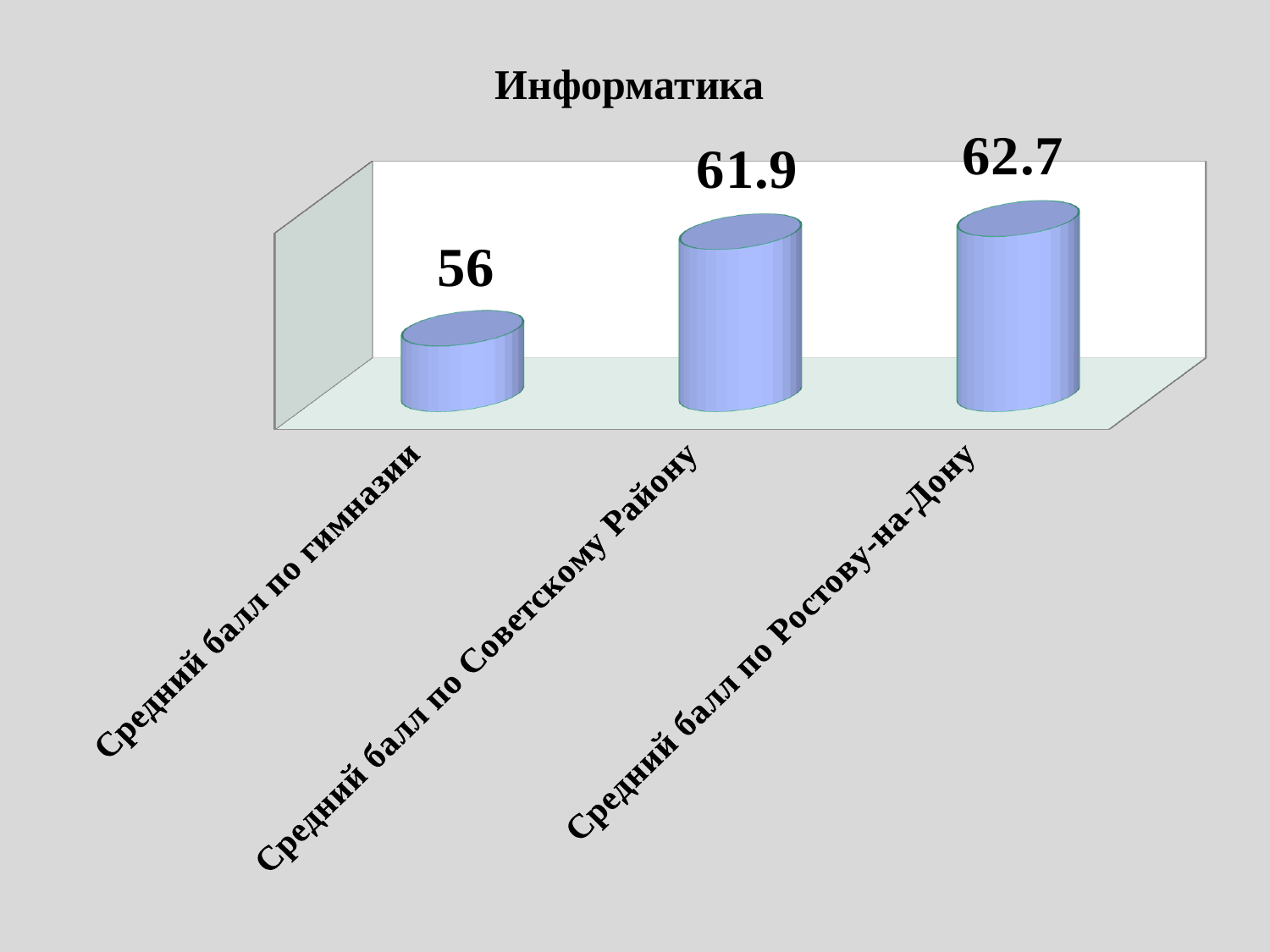
Which category has the lowest value? Средний балл по гимназии What is the difference between the values for "Средний балл по Ростову-на-Дону" and "Средний балл по гимназии"? 6.7 Which category has the highest value? Средний балл по Ростову-на-Дону What is the difference between the values for "Средний балл по Советскому Району" and "Средний балл по гимназии"? 5.9 What is the value for "Средний балл по Ростову-на-Дону"? 62.7 Do the values rise or fall from left to right along the x axis? rise How many categories are shown in the chart? 3 What kind of chart is shown on the slide? bar chart Which is larger: the value for "Средний балл по гимназии" or the value for "Средний балл по Советскому Району"? Средний балл по Советскому Району What is the value for "Средний балл по Советскому Району"? 61.9 What is the title of the chart? Информатика What is the value for "Средний балл по гимназии"? 56